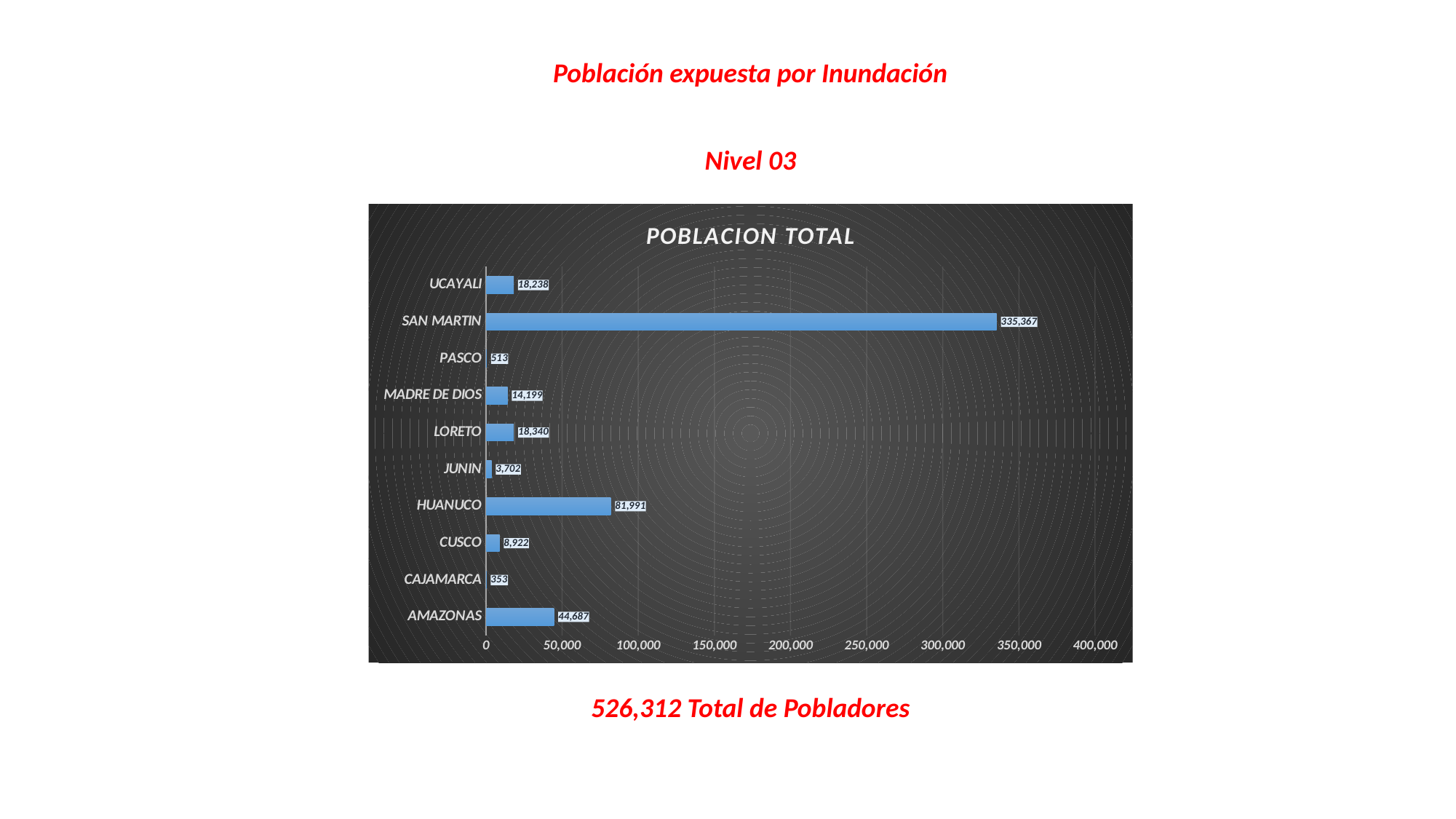
How many regions are plotted in the chart? 10 What is the difference between the values for SAN MARTIN and HUANUCO? 253,376 Is the value for HUANUCO greater or less than 100,000? less Which region has the highest value? SAN MARTIN Which has a larger value, AMAZONAS or CUSCO? AMAZONAS What is the value for CAJAMARCA? 353 What is the value for HUANUCO? 81,991 What type of chart is shown on the slide? bar chart What is the value for AMAZONAS? 44,687 What is the title of the chart? POBLACION TOTAL What is the value for MADRE DE DIOS? 14,199 What is the value for SAN MARTIN? 335,367